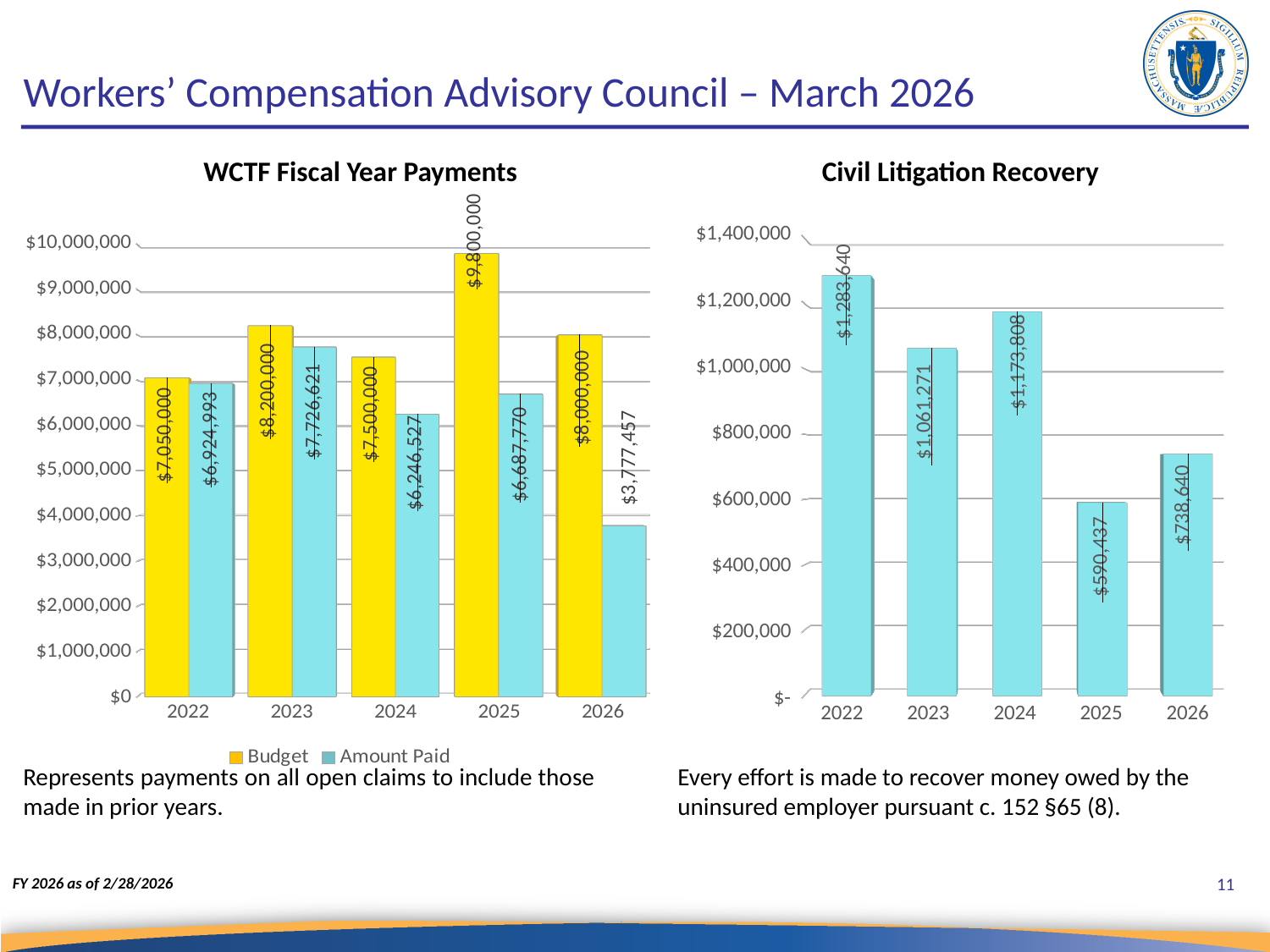
In the WCTF Fiscal Year Payments chart, what is the difference between the Budget and the Amount Paid for 2025? $3,112,230 What kind of chart is the Civil Litigation Recovery chart? bar chart In the Civil Litigation Recovery chart, which year has the lowest value? 2025 In the WCTF Fiscal Year Payments chart, which year has the highest Budget? 2025 In the Civil Litigation Recovery chart, what is the difference between the 2022 value and the 2025 value? $693,203 In the WCTF Fiscal Year Payments chart, which year has the lowest Amount Paid? 2026 How many series does the legend of the WCTF Fiscal Year Payments chart list? 2 How many years are shown on the x axis of the Civil Litigation Recovery chart? 5 In the WCTF Fiscal Year Payments chart, what is the Amount Paid for 2026? $3,777,457 In the Civil Litigation Recovery chart, what is the value for 2024? $1,173,808 In the WCTF Fiscal Year Payments chart, what is the Budget value for 2025? $9,800,000 In the WCTF Fiscal Year Payments chart, is the Amount Paid for 2023 larger or smaller than the Amount Paid for 2024? larger